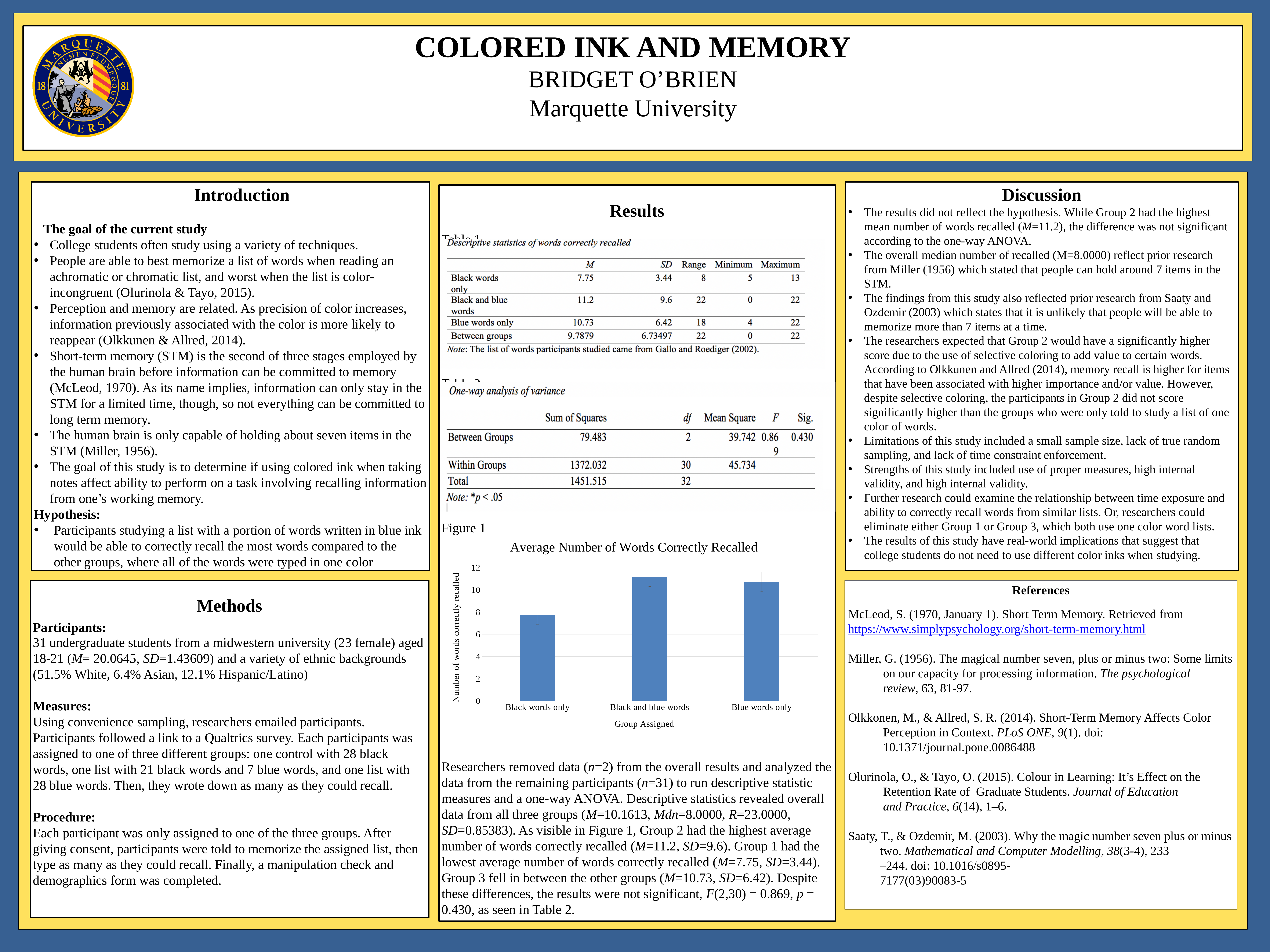
According to Table 1, what is the mean (M) number of words correctly recalled for the Black and blue words group plotted in Figure 1? 11.2 In the Figure 1 chart, is the bar for Black and blue words greater or less than 10? greater What is the title of the chart in Figure 1? Average Number of Words Correctly Recalled Which group has the lowest bar in the Figure 1 chart? Black words only Which group has the highest bar in the Figure 1 chart? Black and blue words What type of chart is shown in Figure 1? bar chart In the Figure 1 chart, is the bar for Blue words only greater or less than 10? greater In the Figure 1 chart, which bar is taller: Black words only or Blue words only? Blue words only In the Figure 1 chart, is the bar for Black words only greater or less than 10? less How many groups are plotted on the x axis of the Figure 1 chart? 3 What is the x-axis title of the Figure 1 chart? Group Assigned